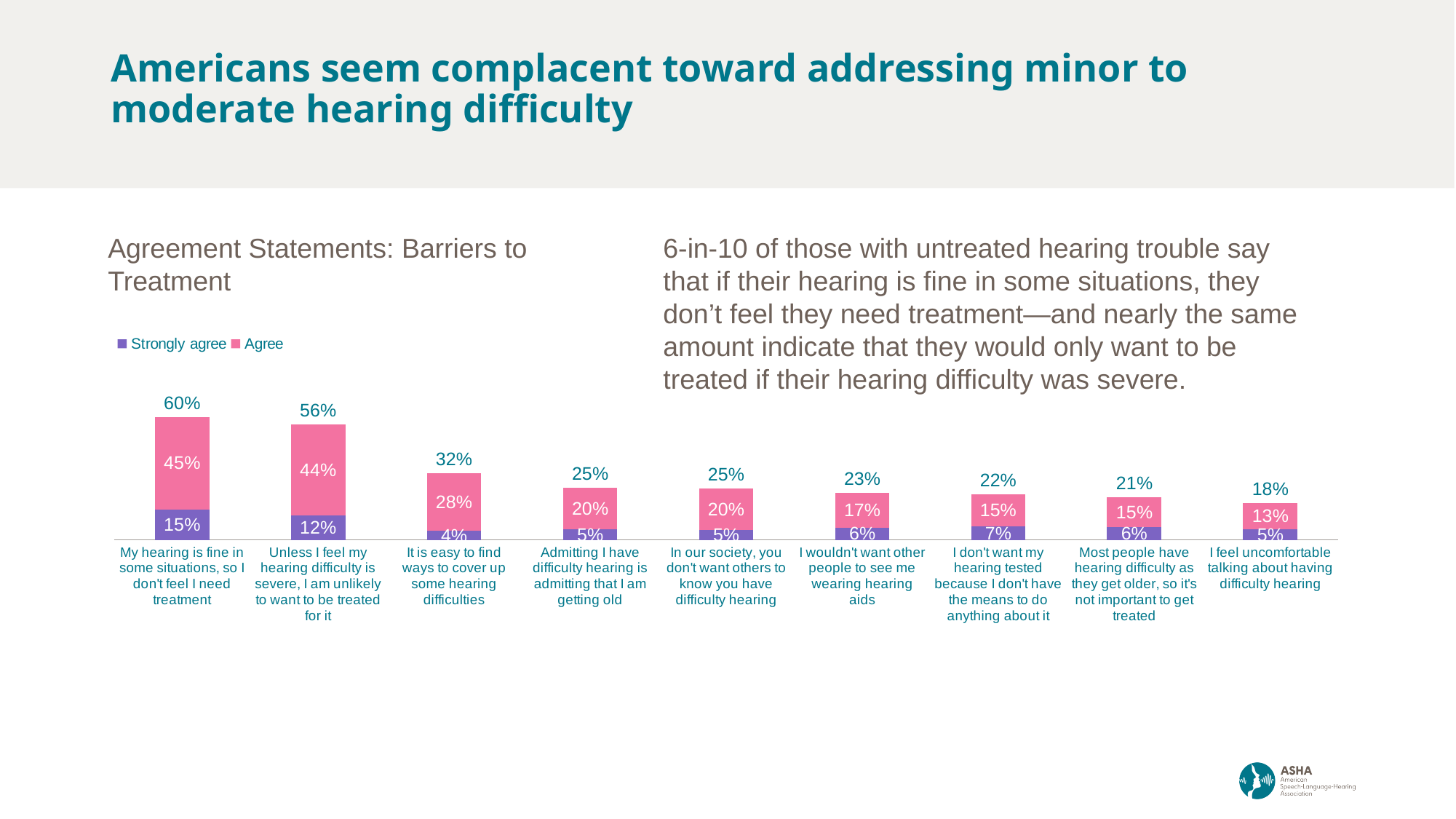
What is the 'Agree' value for 'Unless I feel my hearing difficulty is severe, I am unlikely to want to be treated for it'? 44% What is the total shown above the bar for 'It is easy to find ways to cover up some hearing difficulties'? 32% What is the 'Strongly agree' value for 'My hearing is fine in some situations, so I don't feel I need treatment'? 15% How many statements (categories) are shown in the chart? 9 Which is larger: the 'Agree' value for 'I wouldn't want other people to see me wearing hearing aids' or the 'Agree' value for 'Admitting I have difficulty hearing is admitting that I am getting old'? Admitting I have difficulty hearing is admitting that I am getting old Do the total values rise or fall moving from left to right along the x axis? Fall What is the title of the chart? Agreement Statements: Barriers to Treatment Which statement has the highest total agreement? My hearing is fine in some situations, so I don't feel I need treatment What is the difference between the total for 'My hearing is fine in some situations, so I don't feel I need treatment' and the total for 'Unless I feel my hearing difficulty is severe, I am unlikely to want to be treated for it'? 4% Which statement has the lowest total agreement? I feel uncomfortable talking about having difficulty hearing How many series does the legend list? 2 What kind of chart is shown on the slide? Stacked bar chart